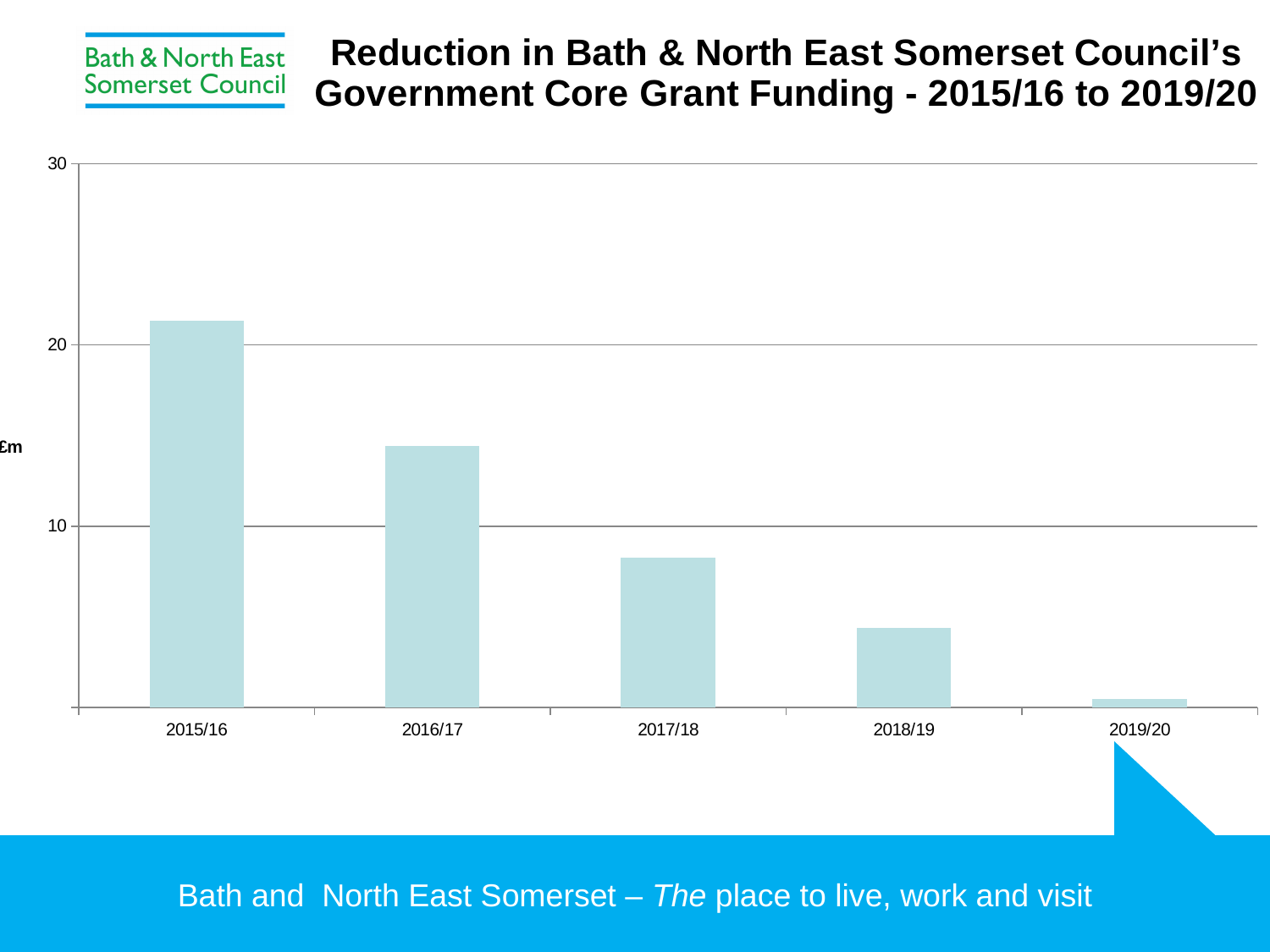
Do the values rise or fall from 2015/16 to 2019/20? fall Is the value for 2016/17 greater or less than 10? greater Which is larger, the value for 2016/17 or the value for 2017/18? 2016/17 Which year has the lowest value? 2019/20 Is the value for 2017/18 greater or less than 10? less What kind of chart is shown on the slide? bar chart Is the value for 2018/19 greater or less than 10? less How many years are plotted on the chart? 5 What unit is shown on the vertical axis label? £m What is the title of the chart? Reduction in Bath & North East Somerset Council's Government Core Grant Funding - 2015/16 to 2019/20 Which year has the highest value? 2015/16